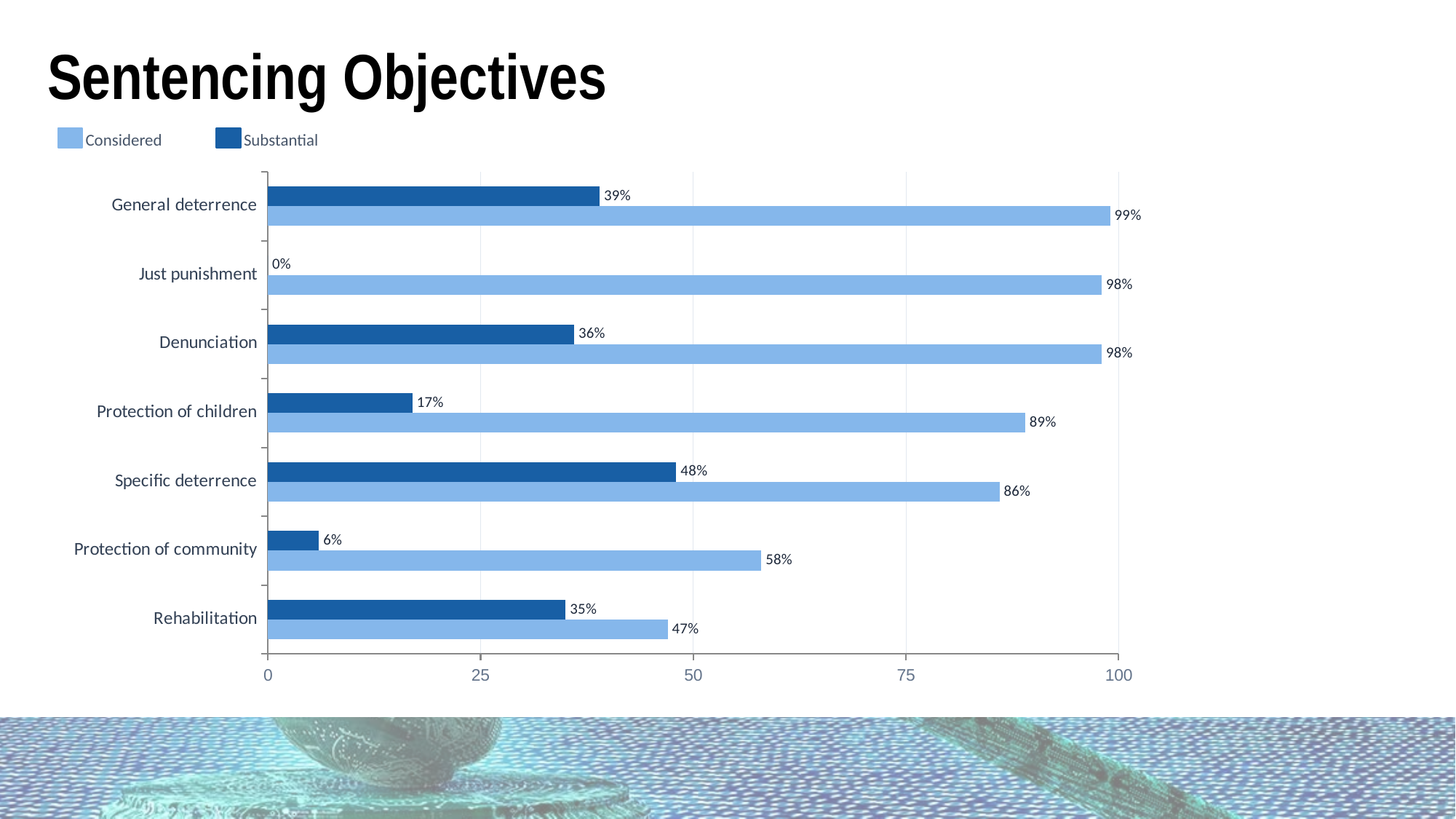
Which category has the lowest Considered value? Rehabilitation Which category has the highest Substantial value? Specific deterrence How many categories are shown on the chart? 7 What is the Considered value for General deterrence? 99% What is the difference between the Considered and Substantial values for Protection of community? 52% What is the title of the slide? Sentencing Objectives What is the Substantial value for Specific deterrence? 48% What kind of chart is shown on the slide? Bar chart Which is larger, the Substantial value for Denunciation or the Substantial value for Rehabilitation? Denunciation What is the Substantial value for Just punishment? 0% How many series does the legend list? 2 Is the Considered value for Protection of children greater or less than 75? greater